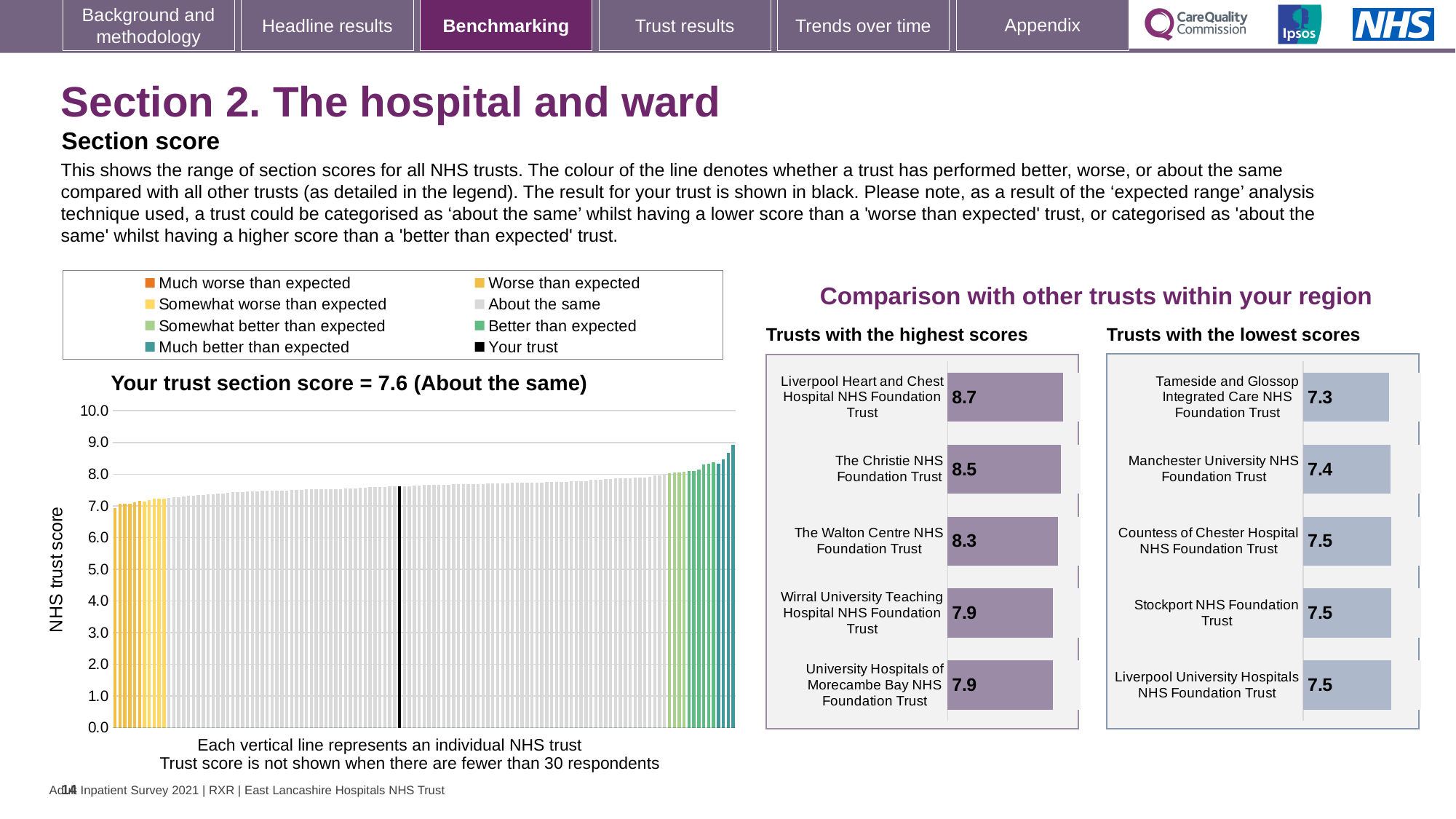
In the 'Trusts with the lowest scores' chart, which trust has the lowest score? Tameside and Glossop Integrated Care NHS Foundation Trust How many entries does the legend above the 'Your trust section score' chart list? 8 In the 'Trusts with the lowest scores' chart, what is the score for Manchester University NHS Foundation Trust? 7.4 In the 'Trusts with the highest scores' chart, what is the score for The Christie NHS Foundation Trust? 8.5 In the 'Your trust section score' chart, do the trust scores rise or fall from left to right? rise How many trusts are shown in the 'Trusts with the highest scores' chart? 5 In the 'Trusts with the highest scores' chart, which trust has the highest score? Liverpool Heart and Chest Hospital NHS Foundation Trust What is the y-axis label of the 'Your trust section score' chart? NHS trust score In the 'Trusts with the highest scores' chart, what is the difference between the scores of Liverpool Heart and Chest Hospital NHS Foundation Trust and The Walton Centre NHS Foundation Trust? 0.4 What kind of chart is the 'Your trust section score' chart? bar chart In the 'Your trust section score' chart, what is the section score for your trust? 7.6 Which is larger: the score for The Christie NHS Foundation Trust in the 'Trusts with the highest scores' chart or the score for Manchester University NHS Foundation Trust in the 'Trusts with the lowest scores' chart? The Christie NHS Foundation Trust